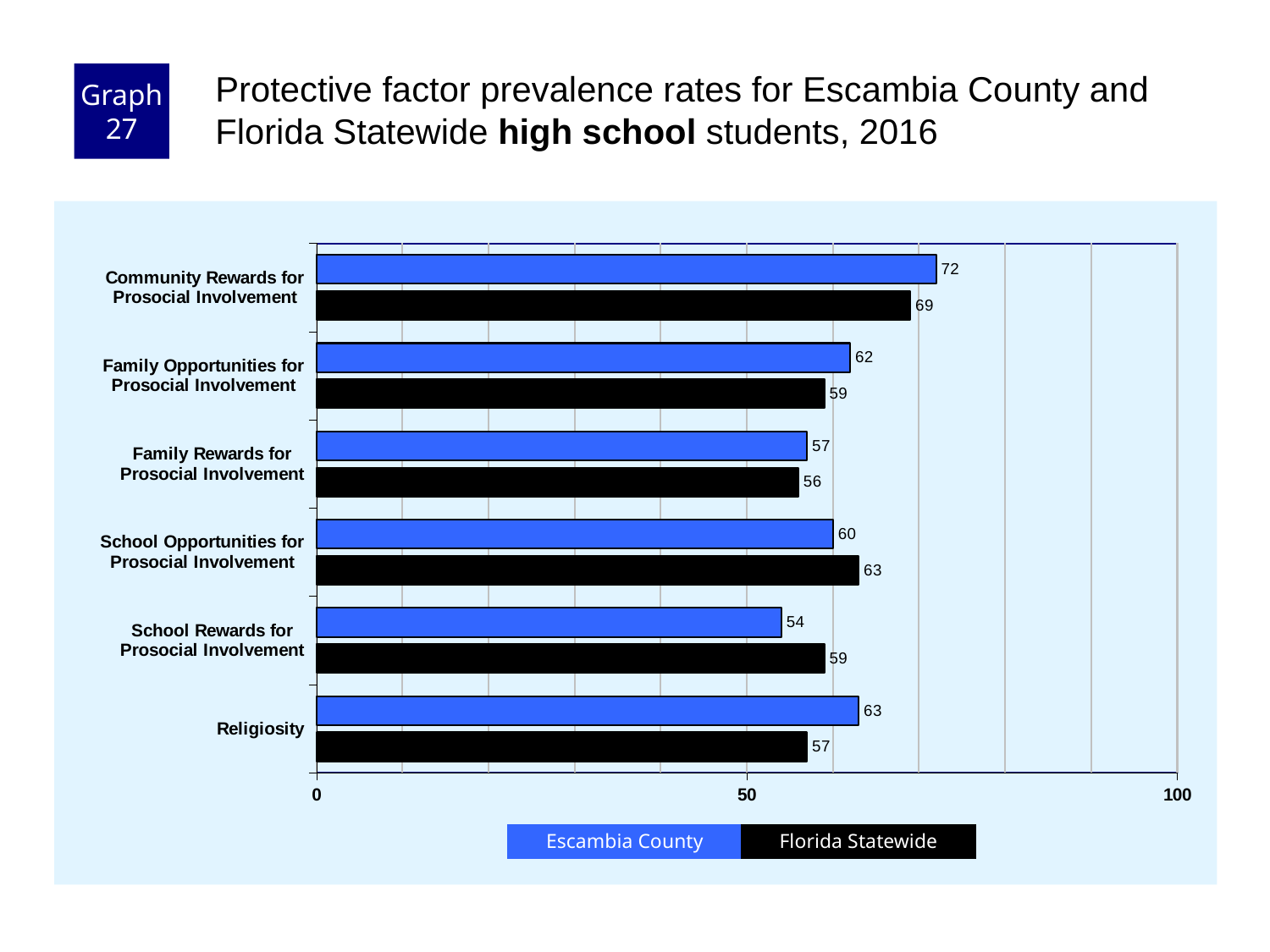
Is the Escambia County value for Religiosity greater or less than 50? greater For School Opportunities for Prosocial Involvement, which is larger: the Escambia County value or the Florida Statewide value? Florida Statewide What is the Florida Statewide value for Religiosity? 57 What kind of chart is shown on the slide? Bar chart What is the Escambia County value for Community Rewards for Prosocial Involvement? 72 How many series does the legend list? 2 What is the Florida Statewide value for School Rewards for Prosocial Involvement? 59 Which category has the highest Escambia County value? Community Rewards for Prosocial Involvement How many categories are shown on the chart? 6 Which category has the lowest Escambia County value? School Rewards for Prosocial Involvement What is the difference between the Florida Statewide and Escambia County values for School Rewards for Prosocial Involvement? 5 What is the difference between the Escambia County and Florida Statewide values for Community Rewards for Prosocial Involvement? 3